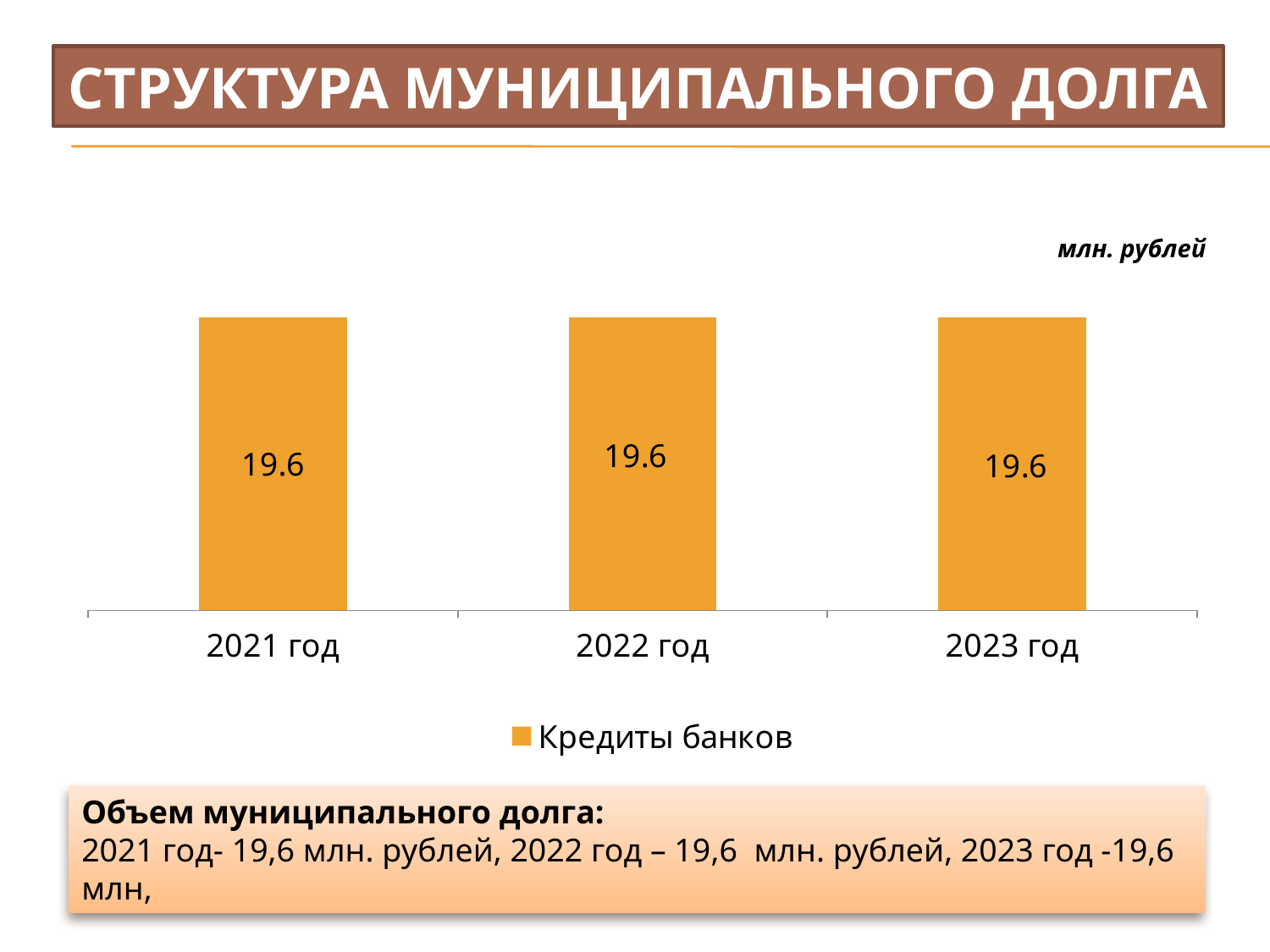
What is the value for 2022 год? 19.6 Is the value for 2022 год larger than, smaller than, or equal to the value for 2021 год? equal What unit is indicated for the chart values? млн. рублей What is the name of the series listed in the legend? Кредиты банков What is the difference between the values for 2023 год and 2021 год? 0 What kind of chart is shown on the slide? bar chart What is the value for 2021 год? 19.6 How many series does the legend list? 1 Do the values rise, fall or stay the same from 2021 год to 2023 год? stay the same What is the value for 2023 год? 19.6 How many categories are shown on the x axis? 3